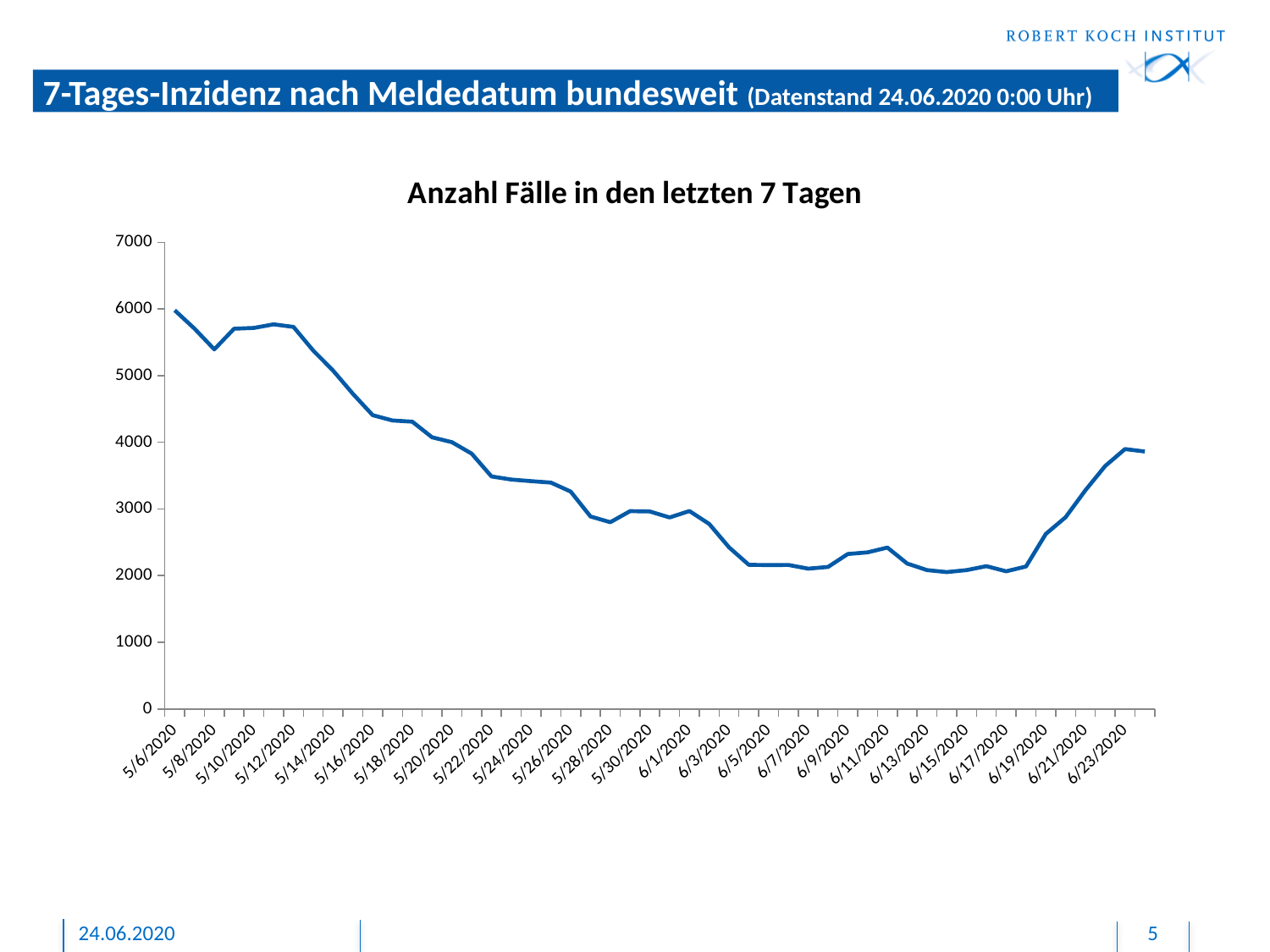
Which is larger, the value for 5/6/2020 or the value for 6/23/2020? 5/6/2020 What kind of chart is shown on the slide? line chart Is the value for 6/11/2020 greater or less than 3000? less Which is larger, the value for 5/20/2020 or the value for 6/1/2020? 5/20/2020 Is the value for 6/23/2020 greater or less than 3000? greater What is the title of the chart? Anzahl Fälle in den letzten 7 Tagen Is the value for 6/5/2020 greater or less than 3000? less Do the values rise or fall from 5/6/2020 to 6/5/2020? fall What is the first date shown on the x axis of the chart? 5/6/2020 On which date is the value highest? 5/6/2020